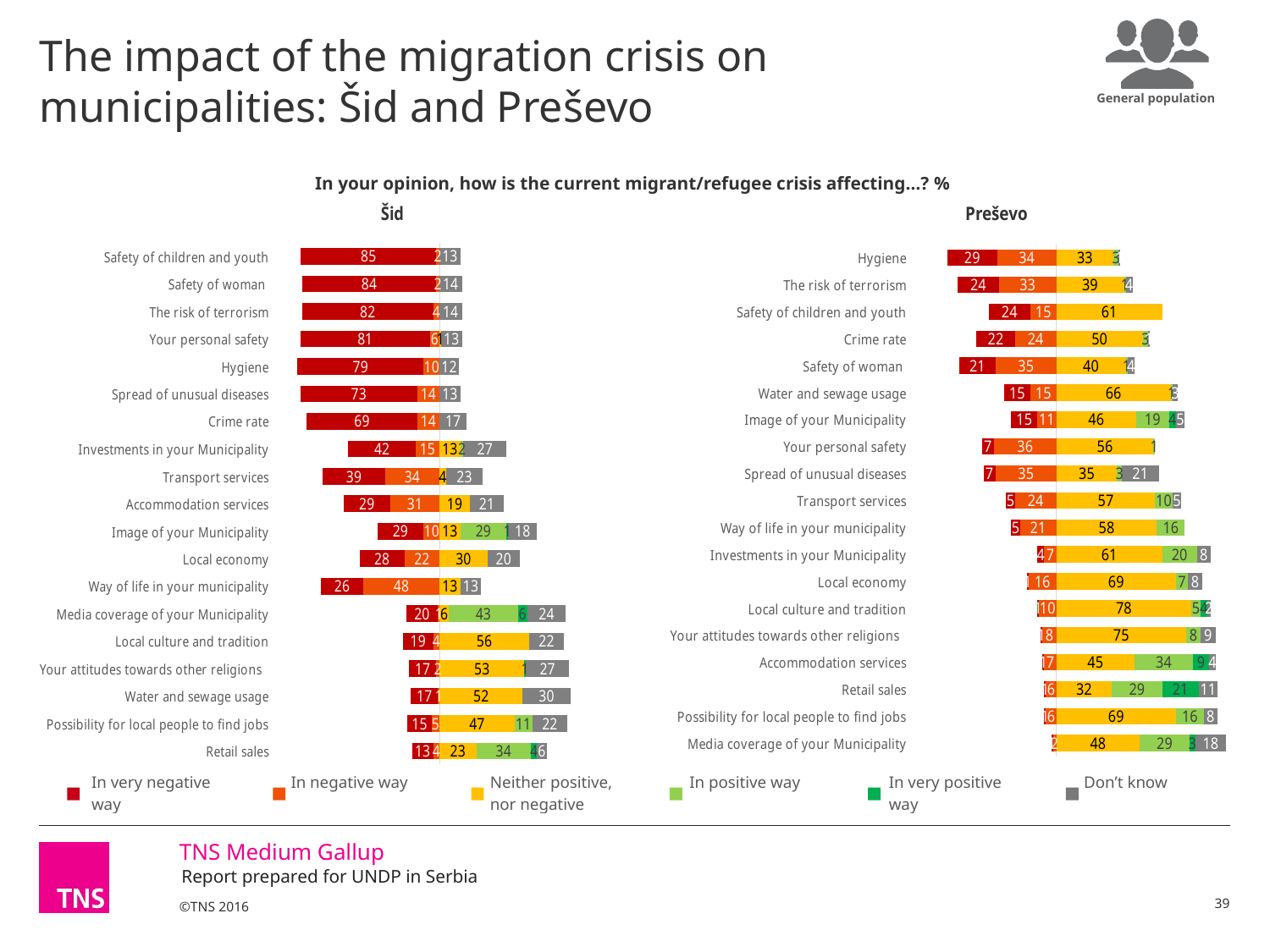
In the Šid chart, which category has the highest 'In very negative way' value? Safety of children and youth In the Šid chart, what percentage say the crisis affects safety of children and youth in a very negative way? 85 In the Preševo chart, what percentage say the crisis affects local culture and tradition in neither a positive nor negative way? 78 In the Preševo chart, what percentage say the crisis affects retail sales in a positive way? 29 In the Preševo chart, what percentage say the crisis affects hygiene in a very negative way? 29 What kind of chart is used for Šid and Preševo? Stacked bar chart How many series does the legend list? 6 In the Preševo chart, which category has the highest 'Neither positive, nor negative' value? Local culture and tradition In the Šid chart, what percentage answered 'Don't know' for water and sewage usage? 30 In the Šid chart, what is the difference between the 'In very negative way' values for safety of children and youth and crime rate? 16 In the Preševo chart, which is larger: the 'In very negative way' value for hygiene or for safety of woman? Hygiene How many categories are shown in the Šid chart? 19